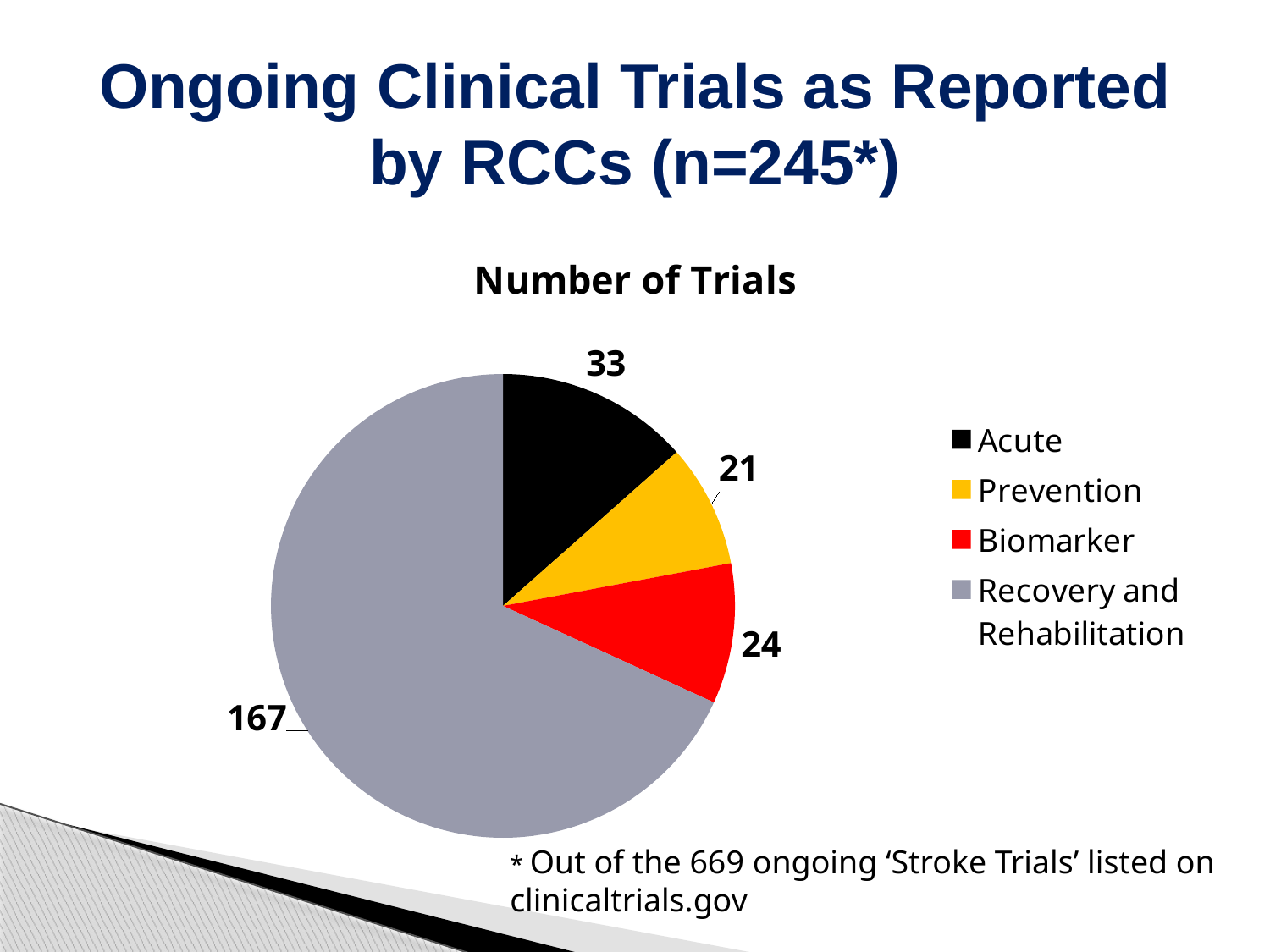
What type of chart is shown on the slide? Pie chart How many categories does the pie chart show? 4 How many trials are in the Acute category? 33 Which category has the largest number of trials? Recovery and Rehabilitation How many more trials are in Recovery and Rehabilitation than in Acute? 134 What is the title of the chart? Number of Trials How many trials are in the Biomarker category? 24 Which category has the smallest number of trials? Prevention How many trials are in the Recovery and Rehabilitation category? 167 What colour represents the Biomarker slice? Red Which has more trials, Biomarker or Prevention? Biomarker How many trials are in the Prevention category? 21